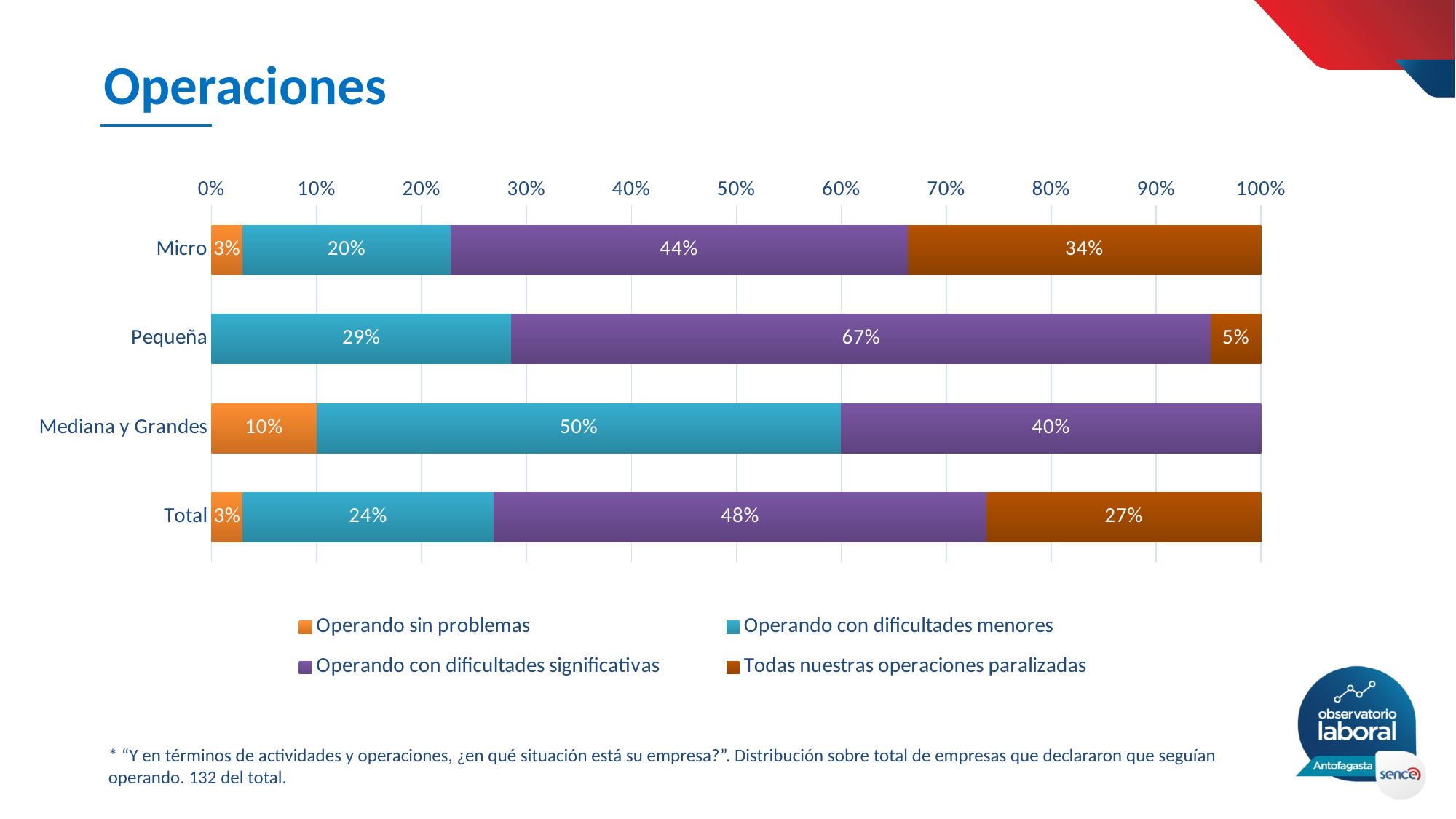
Which category has the highest value for "Operando con dificultades menores"? Mediana y Grandes Which category has the lowest value for "Operando con dificultades significativas"? Mediana y Grandes Which series is shown in purple in the legend? Operando con dificultades significativas How many series does the legend list? 4 What is the value of "Operando con dificultades significativas" for Pequeña? 67% What is the value of "Todas nuestras operaciones paralizadas" for Micro? 34% What is the difference between the "Todas nuestras operaciones paralizadas" values for Micro and Pequeña? 29% Which is larger: "Operando con dificultades significativas" for Micro or for Total? Total What is the value of "Operando sin problemas" for Mediana y Grandes? 10% What is the value of "Operando con dificultades menores" for Total? 24% How many categories are shown on the vertical axis? 4 What kind of chart is shown on the slide? Stacked bar chart